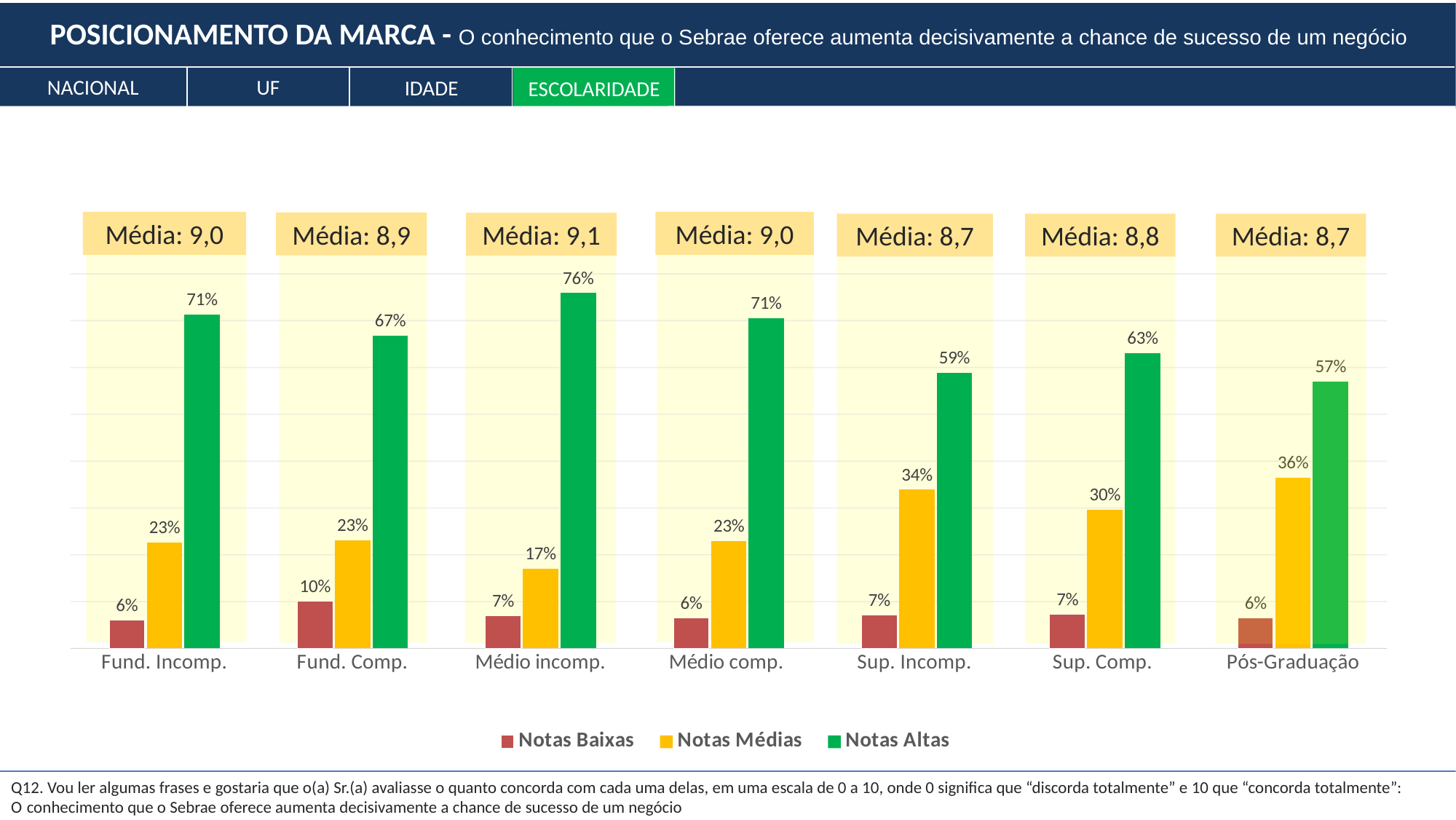
How many education categories are shown on the x axis? 7 What is the Notas Médias value for Pós-Graduação? 36% What is the Notas Altas value for Médio incomp.? 76% What is the Média shown above the Sup. Comp. group? 8,8 What kind of chart is shown on the slide? Bar chart Which tab is highlighted in green at the top of the slide? ESCOLARIDADE Which category has the lowest Notas Altas value? Pós-Graduação What is the Notas Baixas value for Fund. Comp.? 10% Which is larger: the Notas Médias value for Sup. Incomp. or for Sup. Comp.? Sup. Incomp. What is the difference between the Notas Altas values for Fund. Incomp. and Sup. Incomp.? 12% How many series does the legend list? 3 Which category has the highest Notas Altas value? Médio incomp.